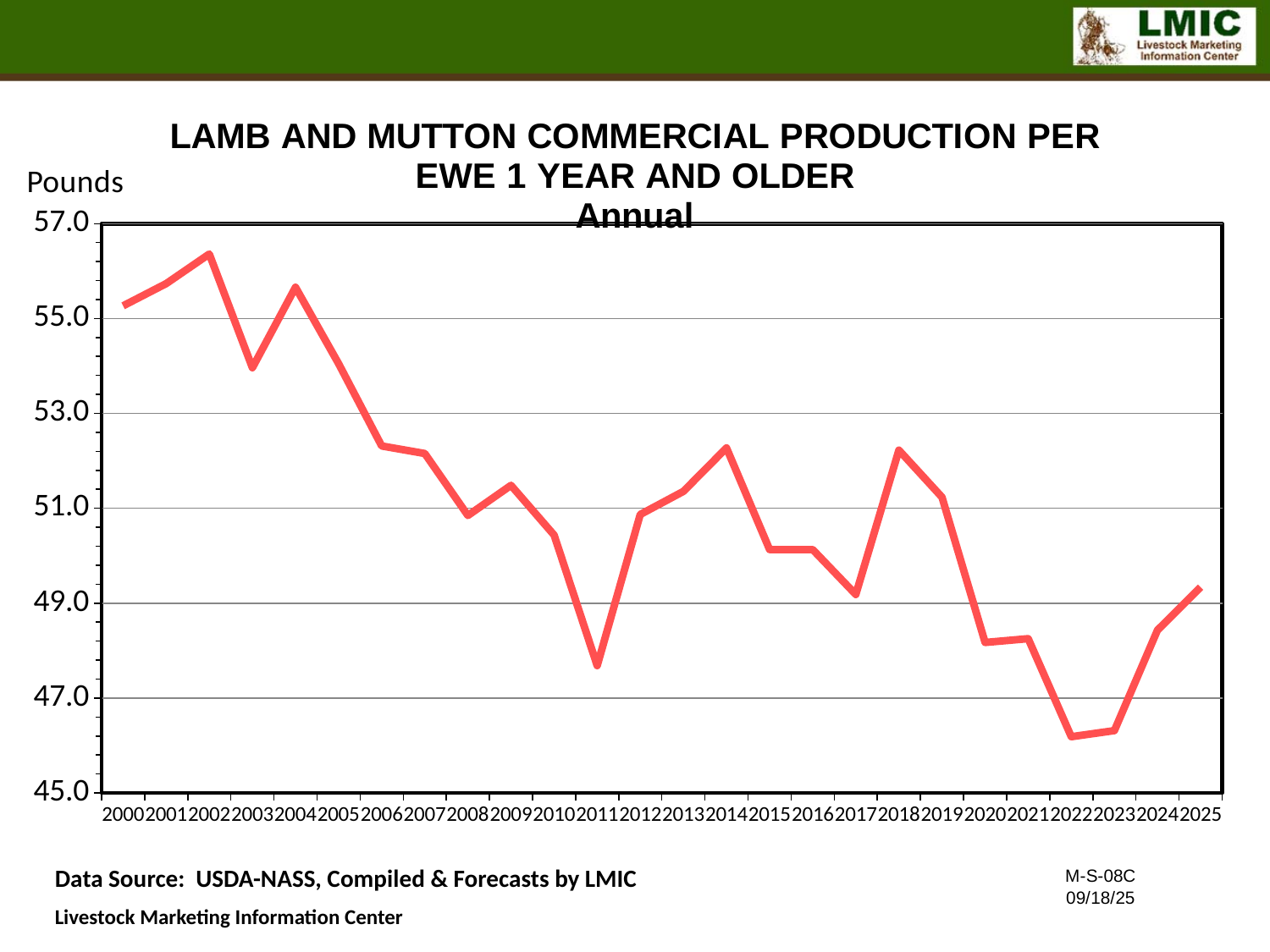
Which is larger, the value for 2002 or the value for 2011? 2002 Is the value for 2011 greater or less than 49.0? less Which year has the highest production per ewe? 2002 What kind of chart is shown on the slide? line chart What is the unit label shown on the y axis? Pounds Is the value for 2014 greater or less than 51.0? greater Is the value for 2020 greater or less than 49.0? less How many years are plotted along the x axis? 26 Which is larger, the value for 2014 or the value for 2020? 2014 Overall, do the values rise or fall from 2000 to 2025? fall